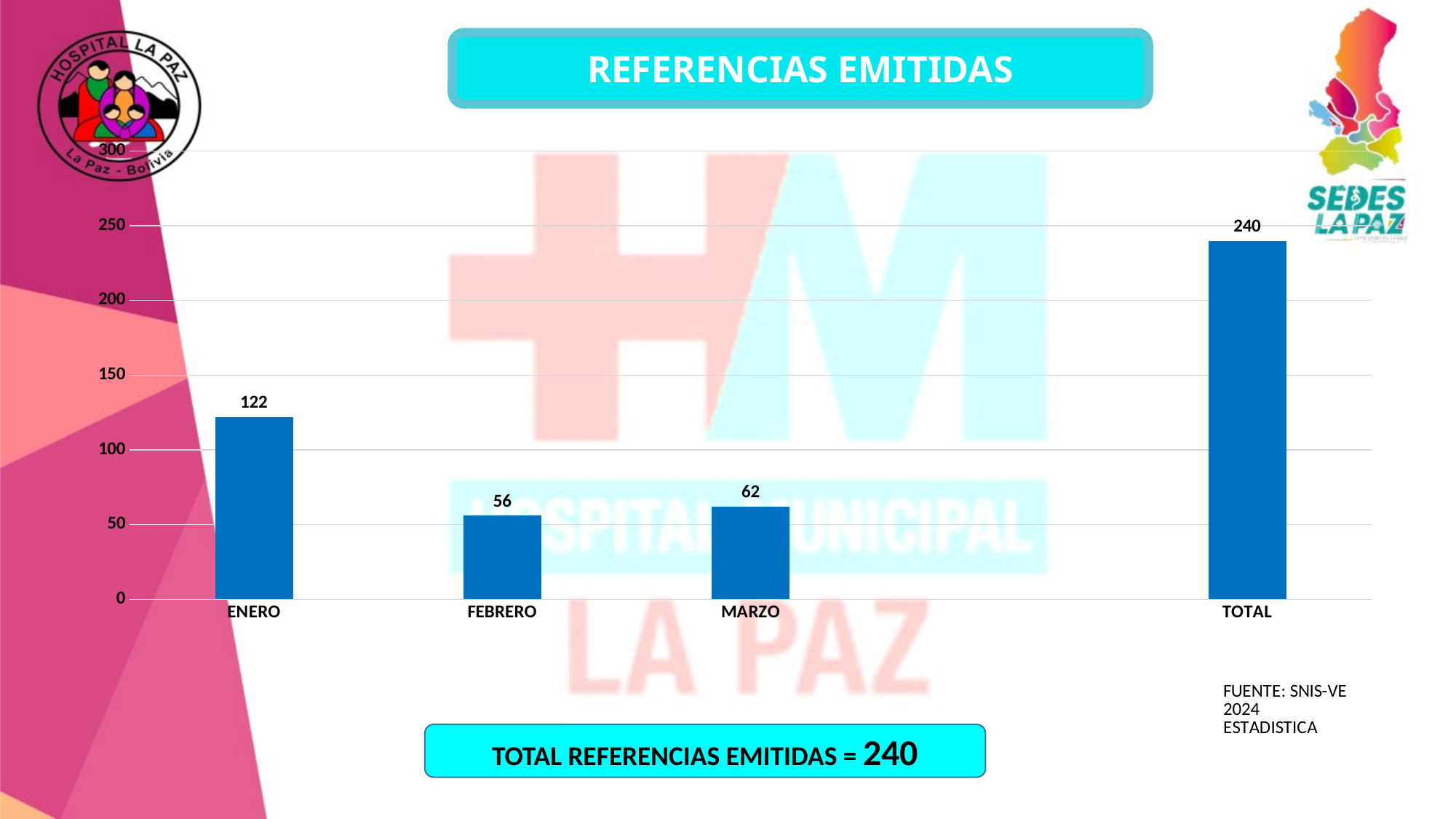
Which category has the lowest value? FEBRERO What is the value for FEBRERO? 56 What is the value for ENERO? 122 What is the difference between the values for ENERO and FEBRERO? 66 How many bars are shown in the chart? 4 Is the value for ENERO greater or less than 100? greater What is the title of the chart? REFERENCIAS EMITIDAS Which is larger, the value for MARZO or the value for FEBRERO? MARZO What is the value for MARZO? 62 What is the value for TOTAL? 240 Among the months ENERO, FEBRERO and MARZO, which has the highest value? ENERO What kind of chart is shown on the slide? bar chart